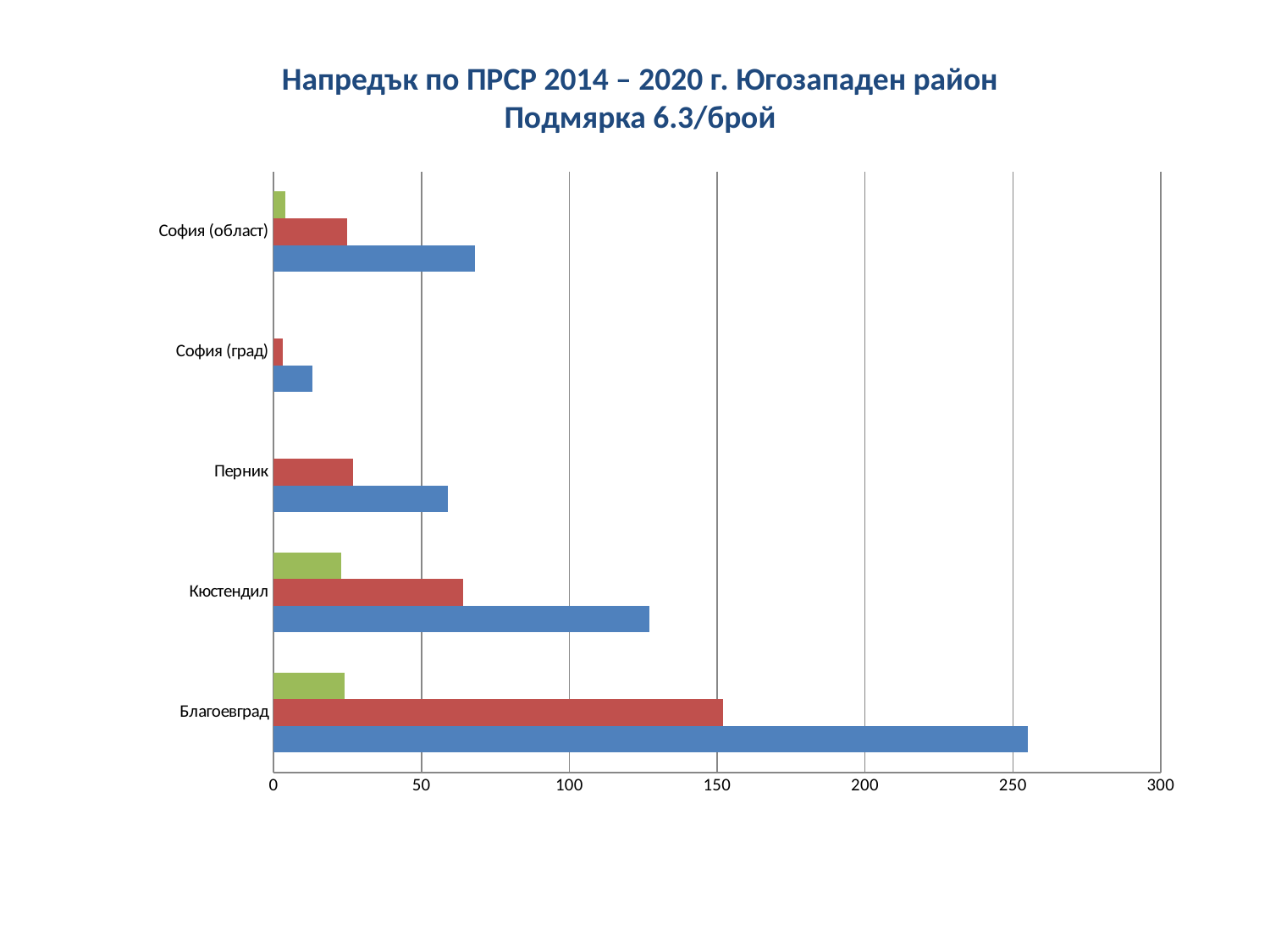
Is the red bar for Кюстендил greater or less than 50? greater Which category has the shortest blue bar? София (град) Is the blue bar for Кюстендил greater or less than 100? greater How many categories (regions) are shown on the vertical axis of the chart? 5 Which category has the longest red bar? Благоевград What is the title of the chart? Напредък по ПРСР 2014 – 2020 г. Югозападен район Подмярка 6.3/брой Is the blue bar for Благоевград greater or less than 200? greater What kind of chart is shown on the slide? bar chart Which has the larger blue bar, Кюстендил or Перник? Кюстендил Which category has the longest blue bar? Благоевград